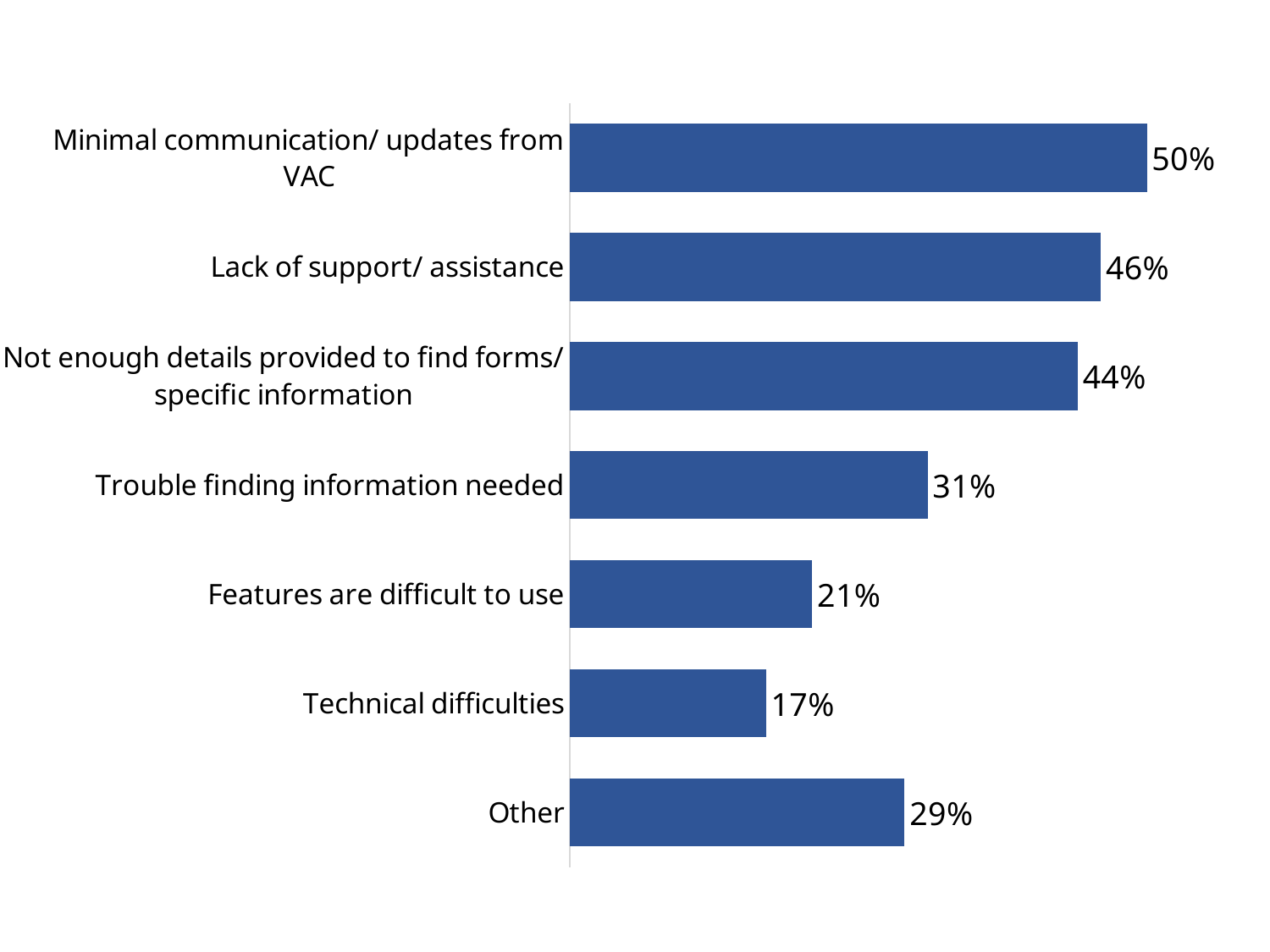
What is the difference between the values for "Minimal communication/ updates from VAC" and "Technical difficulties"? 33% What is the value for "Technical difficulties"? 17% What is the value for "Minimal communication/ updates from VAC"? 50% What is the difference between the values for "Lack of support/ assistance" and "Trouble finding information needed"? 15% What is the value for "Other"? 29% Which is larger, the value for "Lack of support/ assistance" or the value for "Not enough details provided to find forms/ specific information"? Lack of support/ assistance How many categories are shown in the chart? 7 Which category has the highest value? Minimal communication/ updates from VAC What is the value for "Features are difficult to use"? 21% Which is larger, the value for "Other" or the value for "Features are difficult to use"? Other What kind of chart is shown on the slide? Bar chart Which category has the lowest value? Technical difficulties